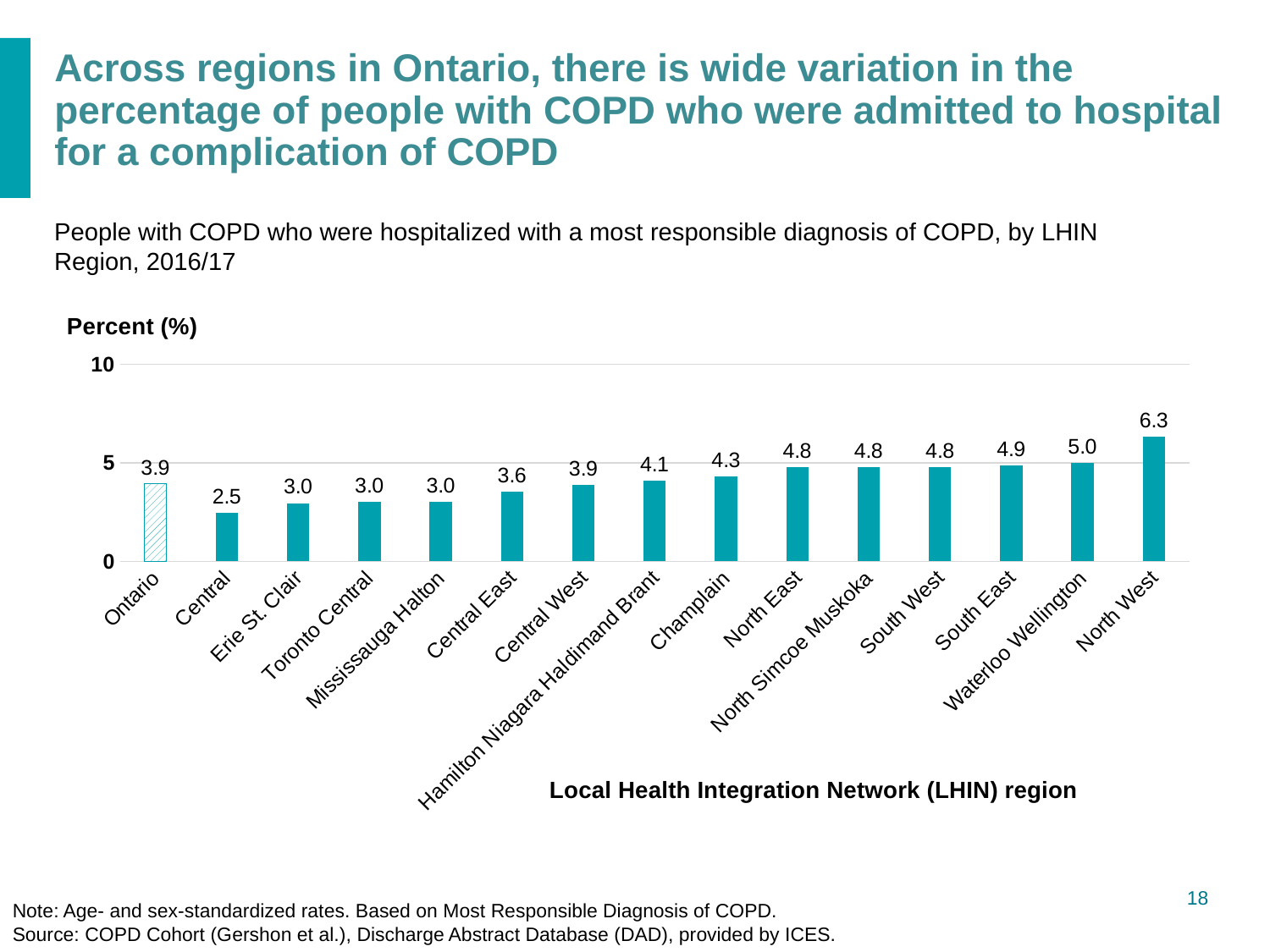
Which LHIN region has the lowest value? Central Which is larger, the value for Champlain or the value for Central East? Champlain Which LHIN region has the highest value? North West What is the value for Hamilton Niagara Haldimand Brant? 4.1 What is the difference between the values for Waterloo Wellington and Ontario? 1.1 What kind of chart is shown on the slide? Bar chart What is the label of the x axis? Local Health Integration Network (LHIN) region What is the value for Ontario? 3.9 What is the difference between the values for North West and Central? 3.8 How many bars are shown in the chart? 15 What is the value for North West? 6.3 Is the value for North West greater or less than 5? greater